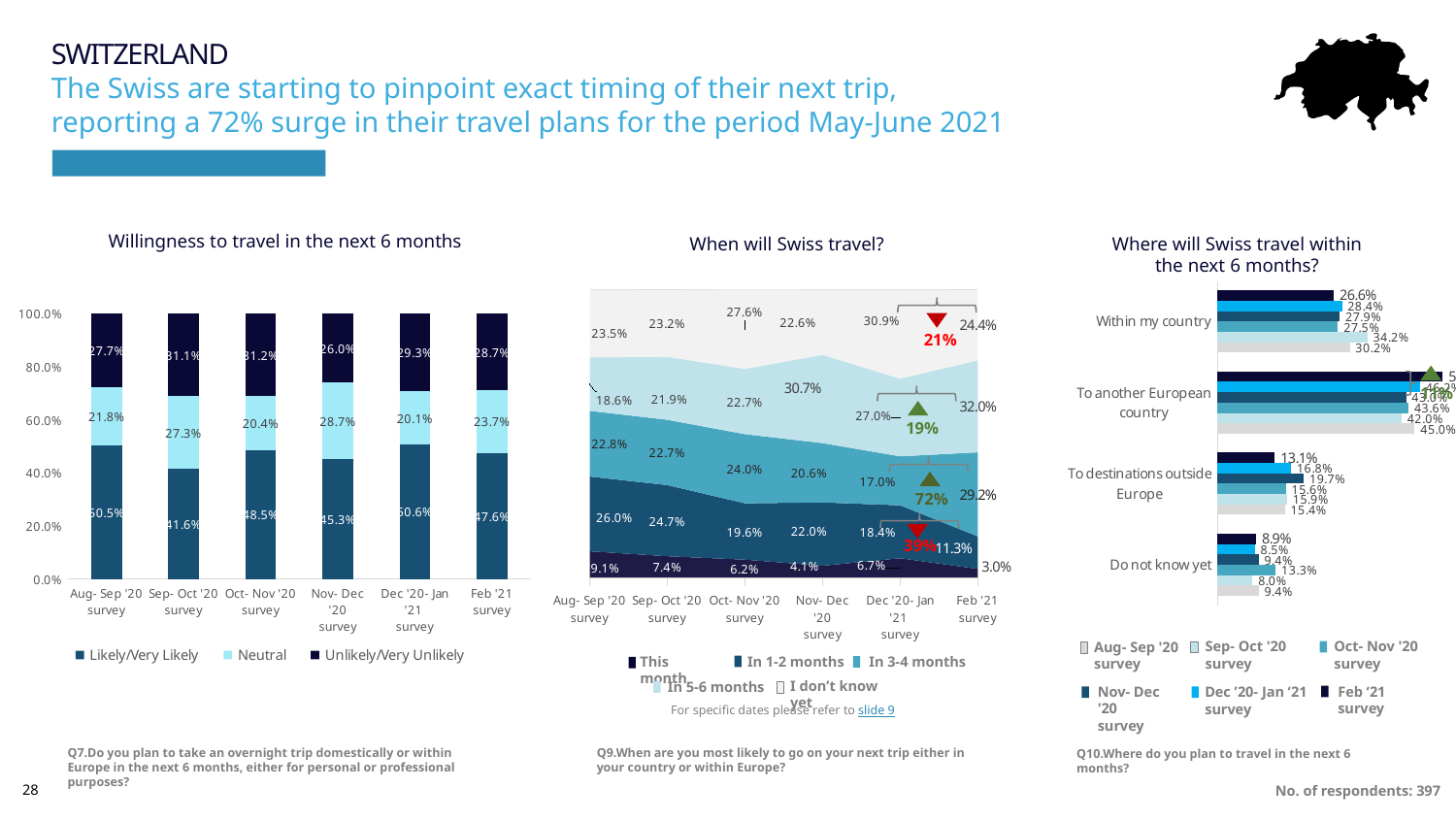
In the 'Willingness to travel in the next 6 months' chart, what is the Neutral value for the Nov-Dec '20 survey? 28.7% In the 'When will Swiss travel?' chart, what is the difference between the 'In 5-6 months' value for the Feb '21 survey and for the Aug-Sep '20 survey? 13.4 percentage points In the 'Where will Swiss travel within the next 6 months?' chart, what is the 'Within my country' value for the Dec '20-Jan '21 survey? 28.4% In the 'When will Swiss travel?' chart, what is the 'I don't know yet' value for the Dec '20-Jan '21 survey? 30.9% What kind of chart is the 'Willingness to travel in the next 6 months' chart? Stacked bar chart In the 'Willingness to travel in the next 6 months' chart, what is the Likely/Very Likely value for the Feb '21 survey? 47.6% In the 'Willingness to travel in the next 6 months' chart, which survey has the lowest Likely/Very Likely value? Sep-Oct '20 survey In the 'When will Swiss travel?' chart, what is the 'This month' value for the Feb '21 survey? 3.0% How many destination categories are shown in the 'Where will Swiss travel within the next 6 months?' chart? 4 In the 'Where will Swiss travel within the next 6 months?' chart, which survey has the highest 'Do not know yet' value? Oct-Nov '20 survey In the 'Willingness to travel in the next 6 months' chart, which is larger: the Neutral value for the Sep-Oct '20 survey or for the Oct-Nov '20 survey? Sep-Oct '20 survey How many series does the legend of the 'Willingness to travel in the next 6 months' chart list? 3